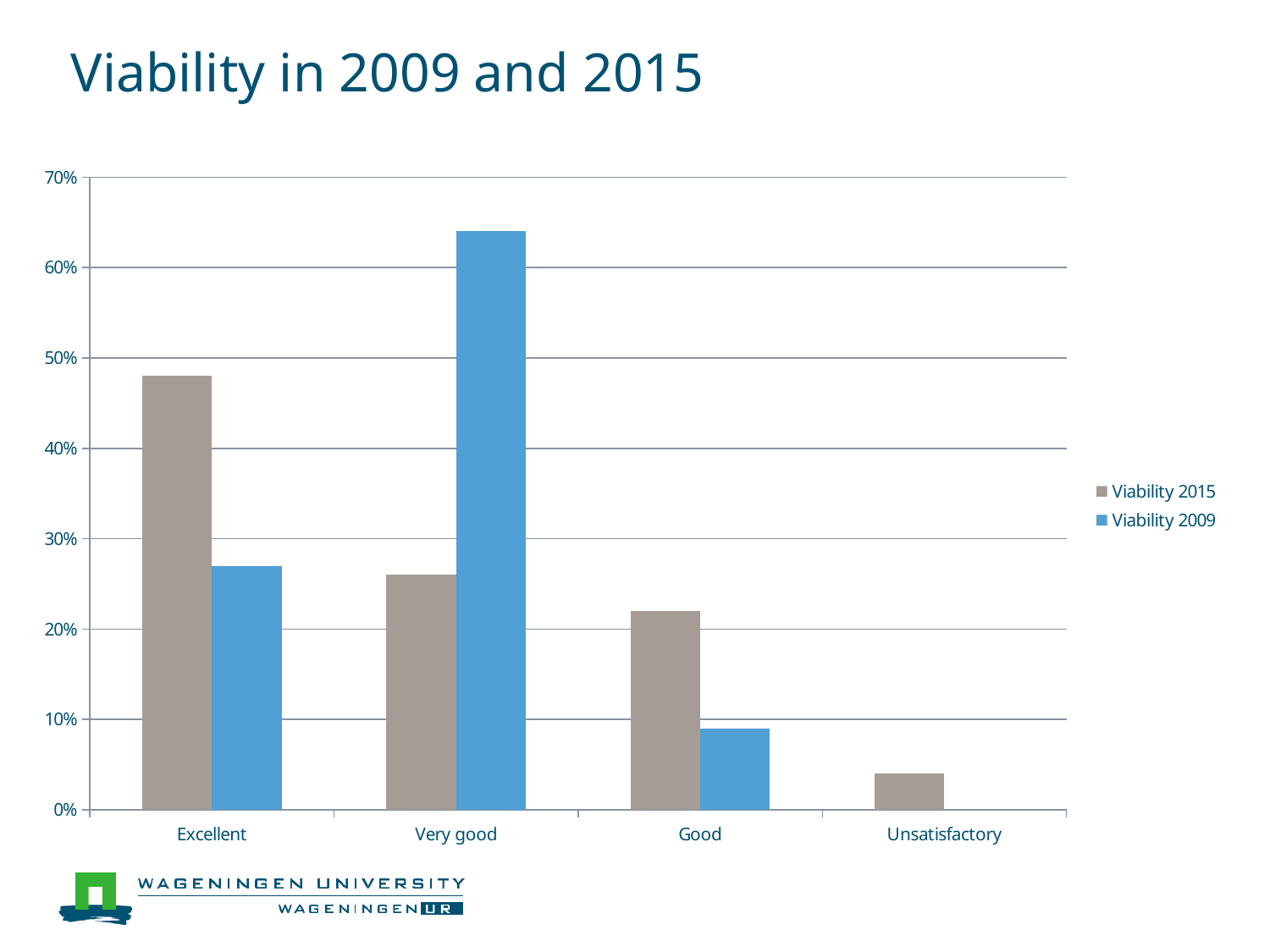
What is the title of the slide? Viability in 2009 and 2015 Which category has the highest value for Viability 2015? Excellent Is the value for Very good in Viability 2009 greater or less than 60%? greater How many categories are shown on the x axis? 4 For the Excellent category, which series has the larger value, Viability 2015 or Viability 2009? Viability 2015 How many series does the legend list? 2 Which category has the highest value for Viability 2009? Very good What kind of chart is shown on the slide? bar chart Is the value for Good in Viability 2009 greater or less than 10%? less Is the value for Excellent in Viability 2015 greater or less than 40%? greater For the Very good category, which series has the larger value, Viability 2015 or Viability 2009? Viability 2009 Which category has the lowest value for Viability 2015? Unsatisfactory